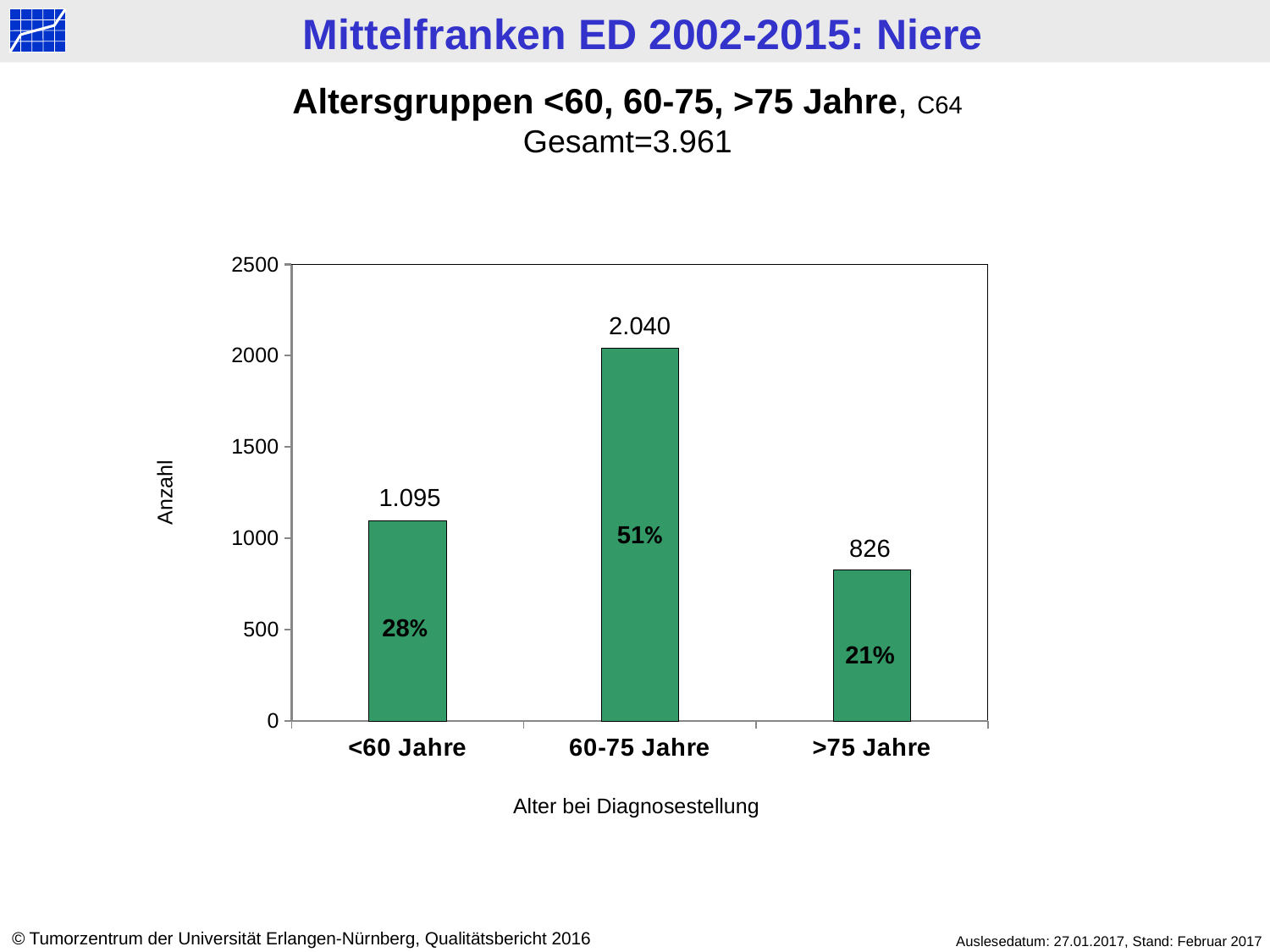
What is the value for the <60 Jahre age group? 1.095 What kind of chart is shown on the slide? bar chart Is the value for 60-75 Jahre greater or less than 1500? greater What is the value for the 60-75 Jahre age group? 2.040 Which is larger, the value for <60 Jahre or the value for >75 Jahre? <60 Jahre What percentage is shown on the bar for the 60-75 Jahre age group? 51% Which age group has the lowest value? >75 Jahre How many age groups are shown on the x axis? 3 What is the difference between the values for 60-75 Jahre and <60 Jahre? 945 Which age group has the highest value? 60-75 Jahre What percentage is shown on the bar for the >75 Jahre age group? 21% What is the value for the >75 Jahre age group? 826